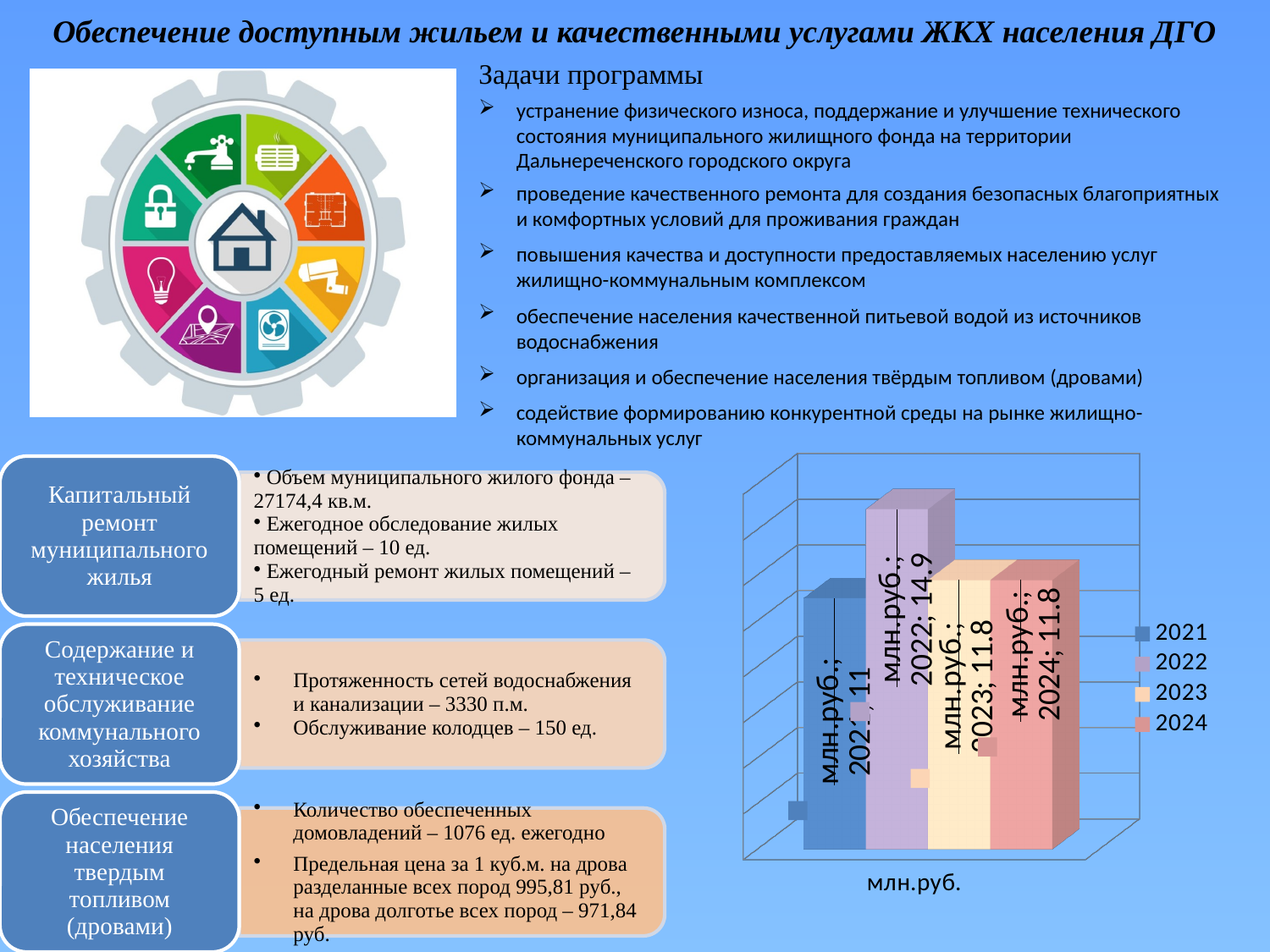
Which is larger in the chart, the value for 2022 or the value for 2023? 2022 What is the difference between the values for 2022 and 2024 in the chart? 3.1 What is the value for 2024 in the chart? 11.8 What is the value for 2023 in the chart? 11.8 How many entries does the chart legend list? 4 How many bars are plotted in the chart? 4 What unit label is shown beneath the chart? млн.руб. What type of chart is shown on the slide? bar chart Which year does the legend list first? 2021 Which year has the highest value in the chart? 2022 What is the value for 2022 in the chart? 14.9